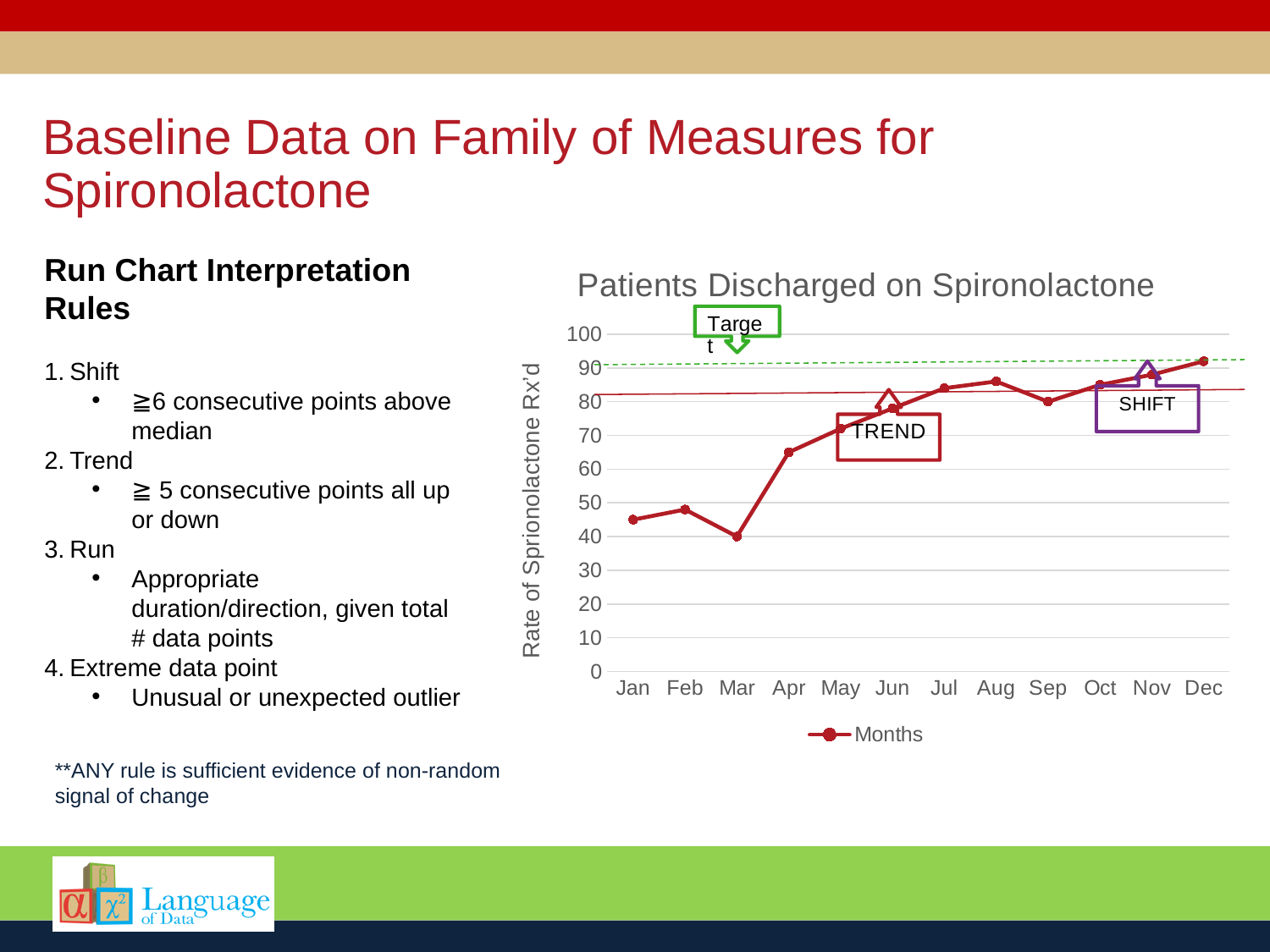
Is the value for Apr greater or less than 60? greater How many series does the chart legend list? 1 What is the label of the y axis of the chart? Rate of Sprionolactone Rx'd Which month has the highest value in the chart? Dec Which is larger, the value for Mar or the value for Jul? Jul How many months are plotted along the x axis of the chart? 12 Do the values generally rise or fall from Jan to Dec? rise What is the title of the chart? Patients Discharged on Spironolactone Is the value for Jan greater or less than 50? less What kind of chart is shown on the slide? line chart Which month has the lowest value in the chart? Mar